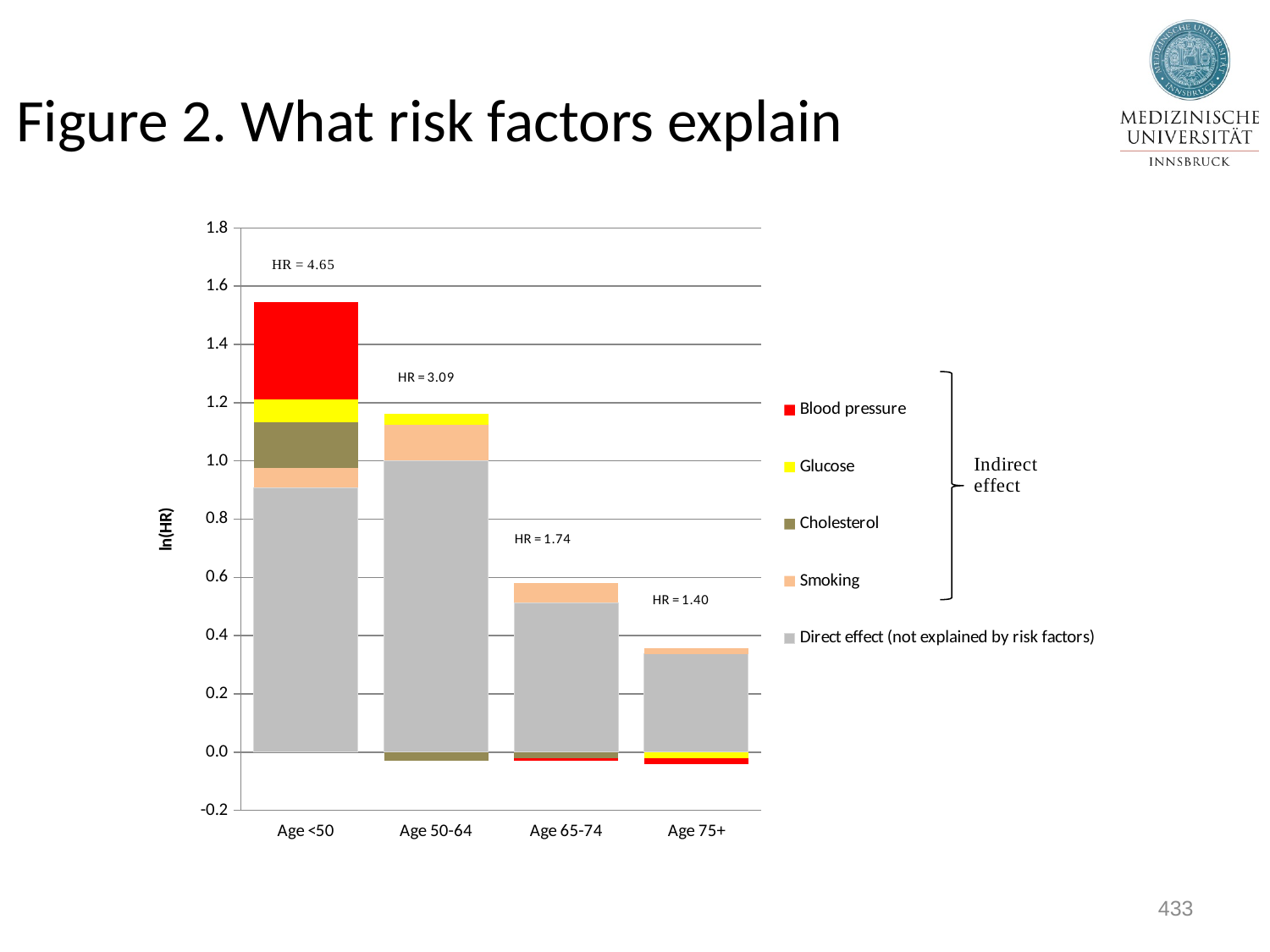
What HR value is printed above the Age 75+ bar? HR = 1.40 Is the top of the stacked bar for Age <50 greater or less than 1.4? greater Do the bar heights rise or fall as age increases along the x axis? fall What HR value is printed above the Age <50 bar? HR = 4.65 What HR value is printed above the Age 50-64 bar? HR = 3.09 What is the label on the y axis? ln(HR) How many age categories are shown on the x axis? 4 What kind of chart is shown on the slide? stacked bar chart Which age category has the tallest stacked bar? Age <50 What HR value is printed above the Age 65-74 bar? HR = 1.74 How many series does the legend list? 5 Which age category has the shortest stacked bar? Age 75+